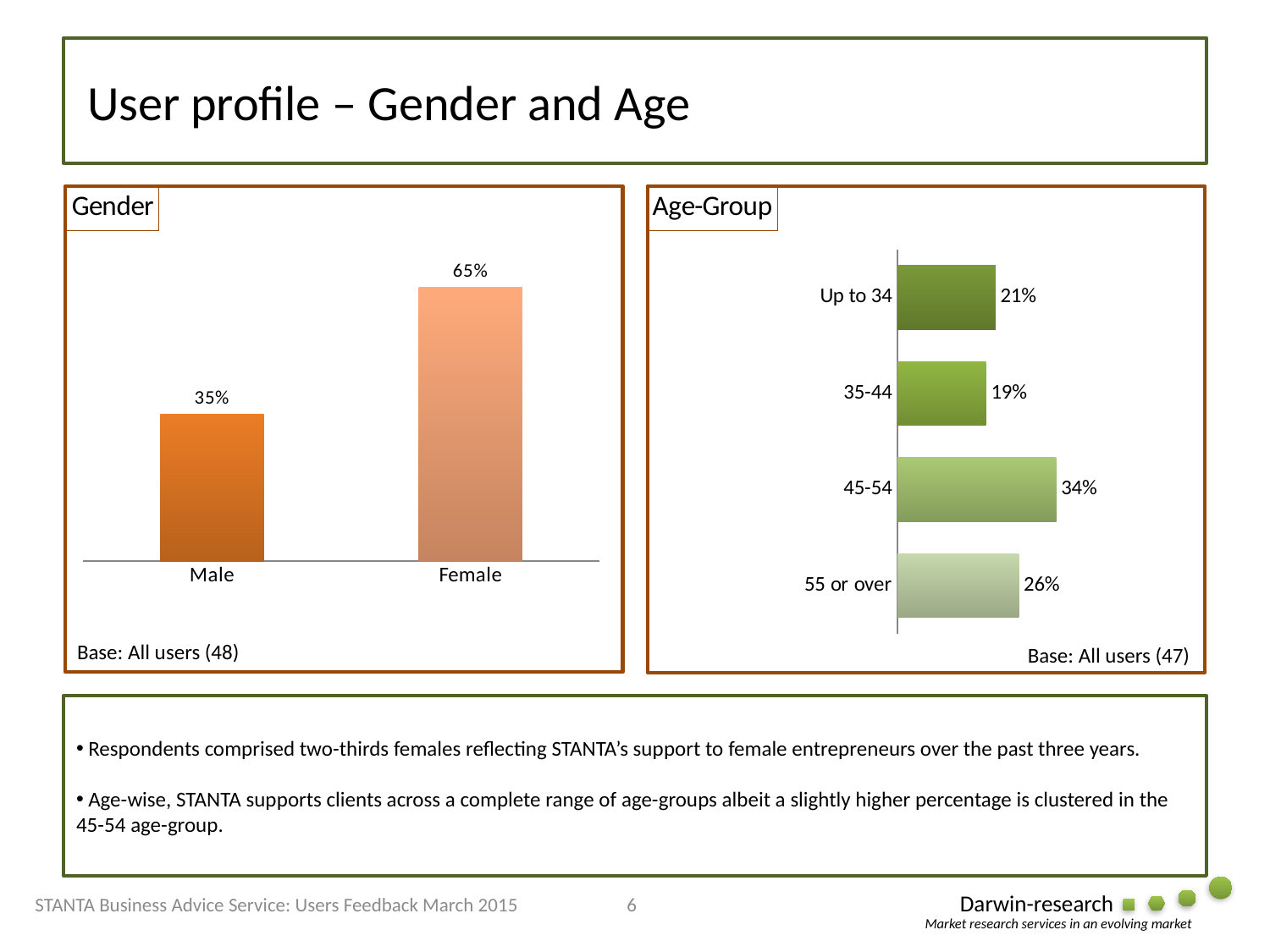
In the Age-Group chart, which age group has the highest value? 45-54 In the Gender chart, what percentage of users are male? 35% In the Age-Group chart, what is the difference between the values for Up to 34 and 35-44? 2% In the Gender chart, which category has the higher value, Male or Female? Female In the Age-Group chart, how many age groups are shown? 4 In the Gender chart, what is the difference between the Female and Male percentages? 30% In the Gender chart, what percentage of users are female? 65% What kind of chart is the Gender chart? Bar chart In the Age-Group chart, what is the value for 55 or over? 26% In the Gender chart, how many categories are shown? 2 In the Age-Group chart, what is the value for 45-54? 34% In the Age-Group chart, which age group has the lowest value? 35-44